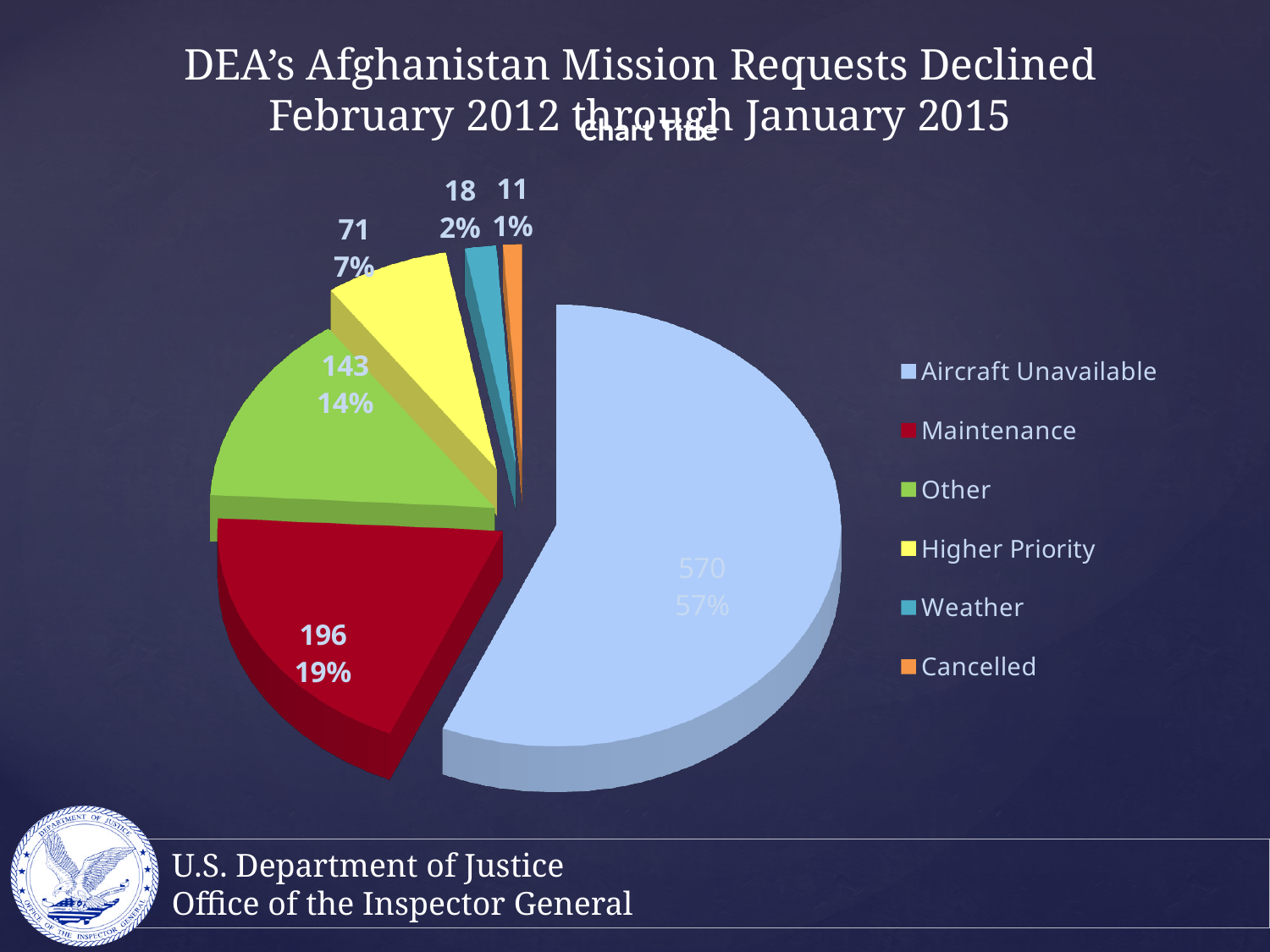
What is the difference between the values for Maintenance and Other? 53 What share of the pie does Weather represent? 2% What share of the pie does Cancelled represent? 1% What kind of chart is shown on the slide? Pie chart What is the value for Aircraft Unavailable? 570 Which category has the largest slice of the pie? Aircraft Unavailable What is the value for Other? 143 Which is larger, the value for Higher Priority or the value for Weather? Higher Priority What is the value for Maintenance? 196 How many categories does the pie chart show? 6 What is the value for Higher Priority? 71 Which category has the smallest slice of the pie? Cancelled